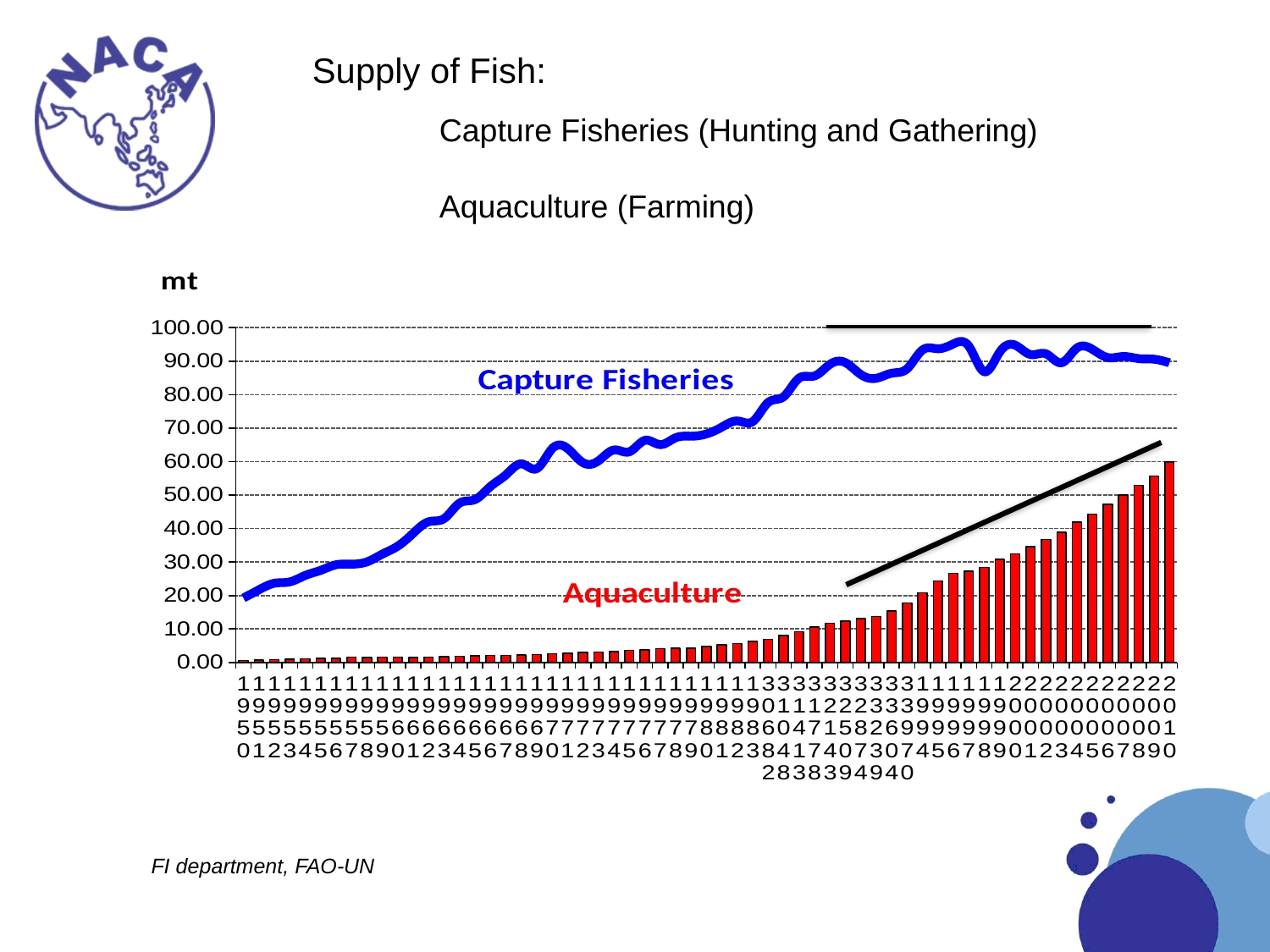
What kind of chart is shown on the slide? A combined line and bar chart Is the value of the first (leftmost) Aquaculture bar greater or less than 10.00? less What is the highest value shown on the vertical axis of the chart? 100.00 How many data series are plotted on the chart? 2 Is the value of the last (rightmost) Aquaculture bar greater or less than 50.00? greater What unit label is shown on the vertical axis of the chart? mt Which series has the larger values throughout the chart, Capture Fisheries or Aquaculture? Capture Fisheries Is the value of the first (leftmost) Capture Fisheries point greater or less than 30.00? less Which series is drawn as bars on the chart? Aquaculture Do the Aquaculture bars rise or fall from left to right along the x axis? Rise Which series is drawn as a line on the chart? Capture Fisheries